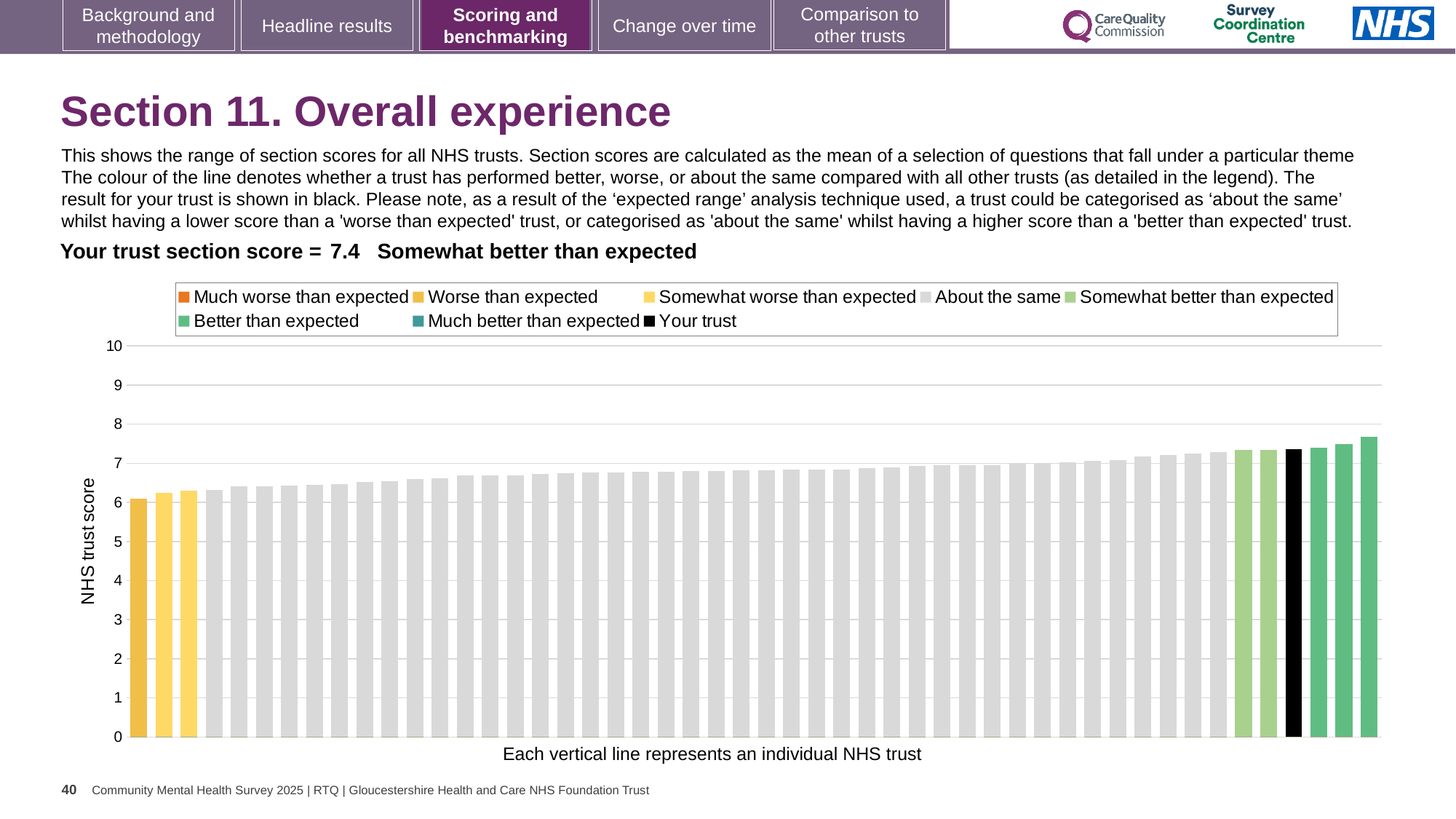
Is the value of the leftmost (lowest) bar greater or less than 7? less Which is larger: the black 'Your trust' bar or the rightmost bar? the rightmost bar Which legend category does the highest bar on the chart belong to? Better than expected Is the value of the black 'Your trust' bar greater or less than 7? greater What colour is used for the 'Your trust' bar according to the legend? black What is the section score for your trust (the black bar)? 7.4 What kind of chart is shown on the slide? bar chart Is the value of the rightmost (highest) bar greater or less than 8? less How many entries does the chart legend list? 8 Do the bar values rise or fall from left to right across the chart? rise What is the label on the vertical axis of the chart? NHS trust score How many bars are coloured as 'Better than expected' (green)? 3